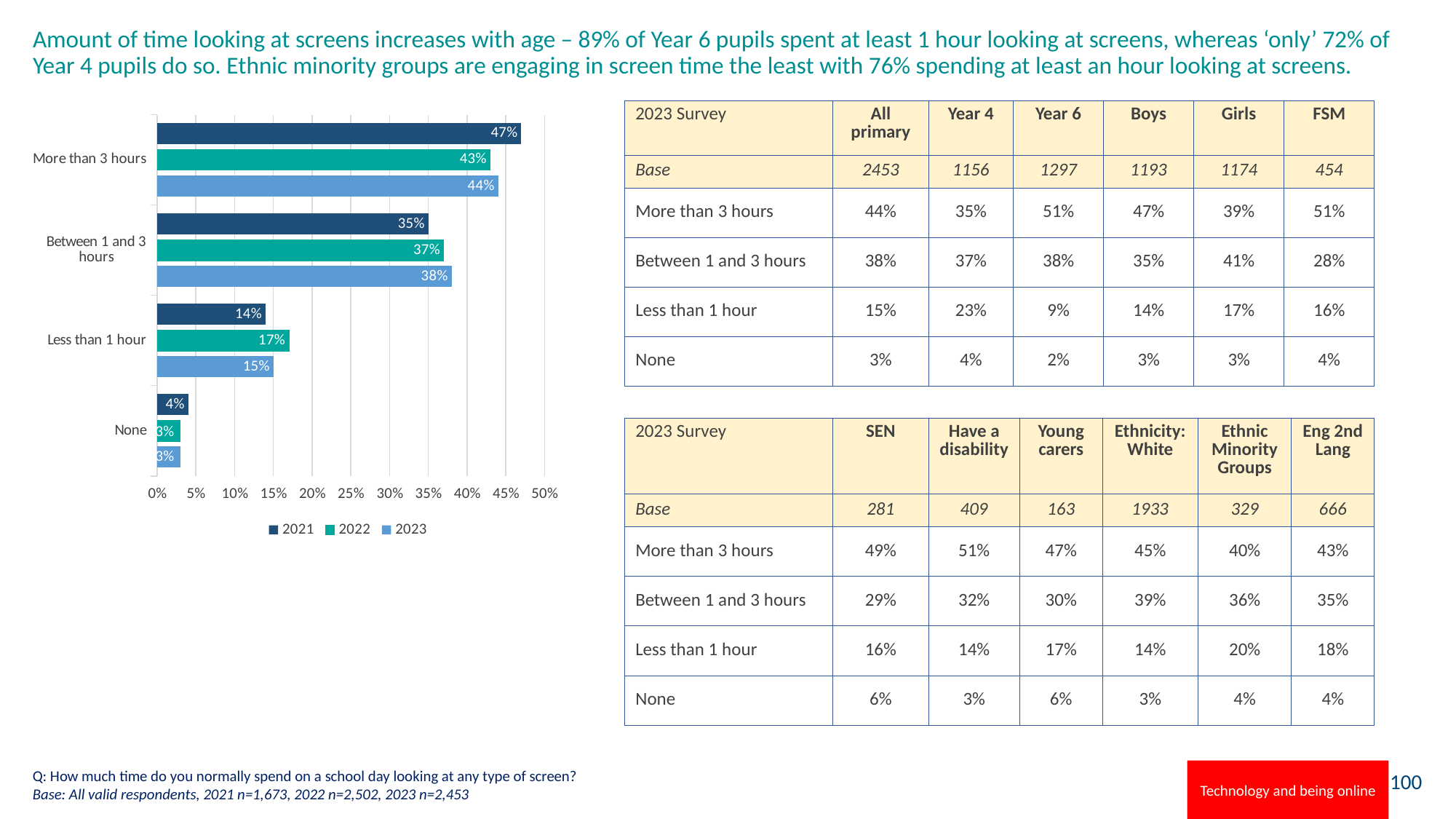
Which category has the lowest value for the 2022 series? None Which category has the highest value for the 2023 series? More than 3 hours What is the 2022 value for 'Less than 1 hour'? 17% What is the 2021 value for 'More than 3 hours'? 47% What is the 2023 value for 'Between 1 and 3 hours'? 38% What is the difference between the 2021 and 2022 values for 'More than 3 hours'? 4% How many categories are shown on the chart? 4 Which series is shown in the darkest blue colour in the legend? 2021 What kind of chart is shown on the slide? bar chart Which is larger for 'Less than 1 hour': the 2021 value or the 2022 value? 2022 What is the 2021 value for 'None'? 4% How many series does the chart's legend list? 3